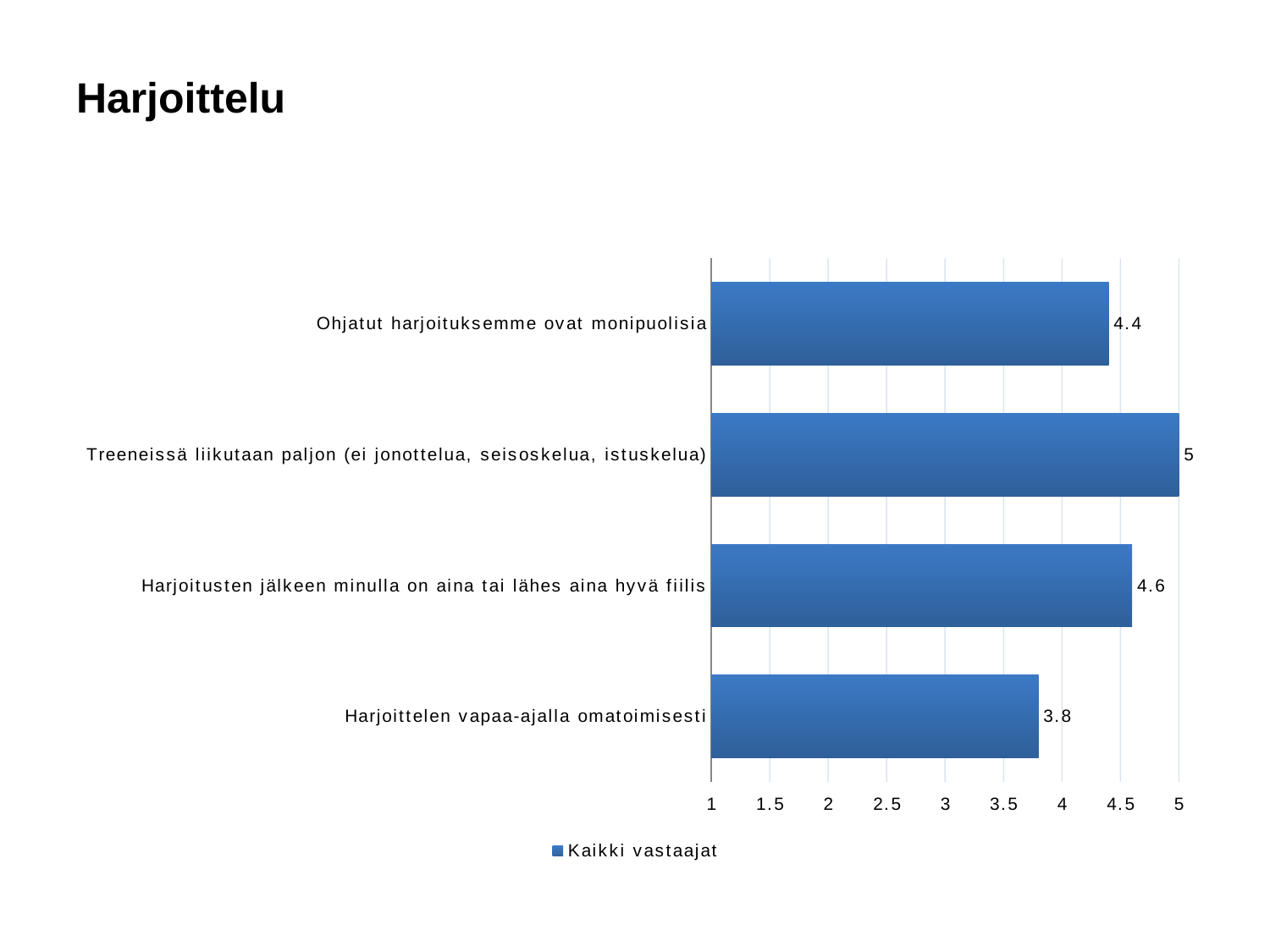
Which category has the highest value? Treeneissä liikutaan paljon (ei jonottelua, seisoskelua, istuskelua) What is the value for "Harjoittelen vapaa-ajalla omatoimisesti"? 3.8 What is the value for "Harjoitusten jälkeen minulla on aina tai lähes aina hyvä fiilis"? 4.6 Is the value for "Harjoittelen vapaa-ajalla omatoimisesti" greater or less than 4? less What kind of chart is shown on the slide? bar chart What is the name of the series in the legend? Kaikki vastaajat What is the difference between the values for "Treeneissä liikutaan paljon (ei jonottelua, seisoskelua, istuskelua)" and "Harjoittelen vapaa-ajalla omatoimisesti"? 1.2 How many categories are shown in the chart? 4 Which category has the lowest value? Harjoittelen vapaa-ajalla omatoimisesti How many series does the legend list? 1 Which has a larger value: "Ohjatut harjoituksemme ovat monipuolisia" or "Harjoitusten jälkeen minulla on aina tai lähes aina hyvä fiilis"? Harjoitusten jälkeen minulla on aina tai lähes aina hyvä fiilis What is the value for "Ohjatut harjoituksemme ovat monipuolisia"? 4.4